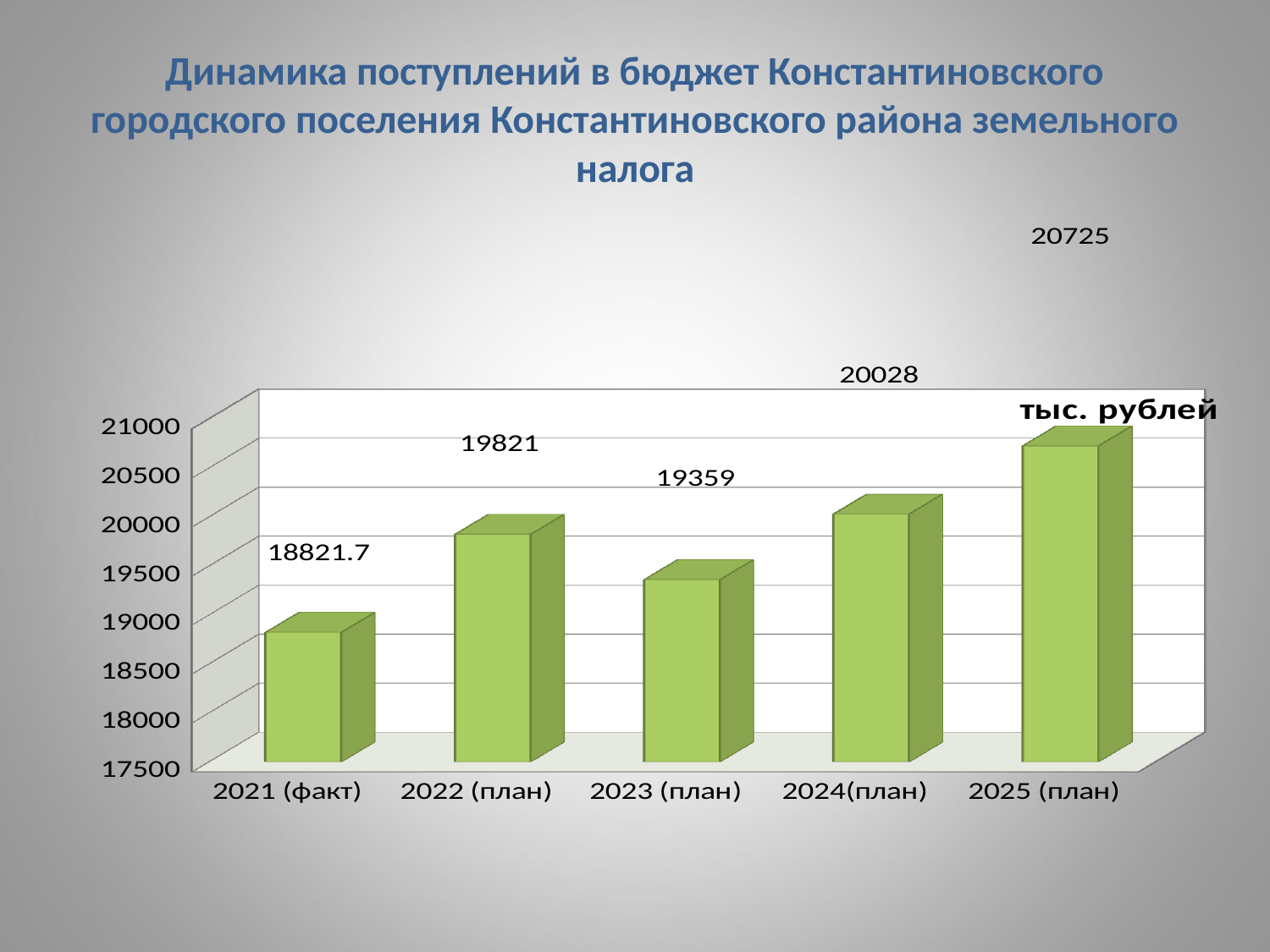
How many categories are shown on the x axis? 5 What kind of chart is shown on the slide? bar chart What unit is indicated for the values on the chart? тыс. рублей Which category has the highest value? 2025 (план) Which category has the lowest value? 2021 (факт) Which is larger, the value for 2022 (план) or the value for 2023 (план)? 2022 (план) What is the value for 2021 (факт)? 18821.7 What is the value for 2025 (план)? 20725 What is the difference between the values for 2022 (план) and 2023 (план)? 462 What is the difference between the values for 2025 (план) and 2024(план)? 697 What is the value for 2023 (план)? 19359 Is the value for 2021 (факт) greater or less than 19000? less